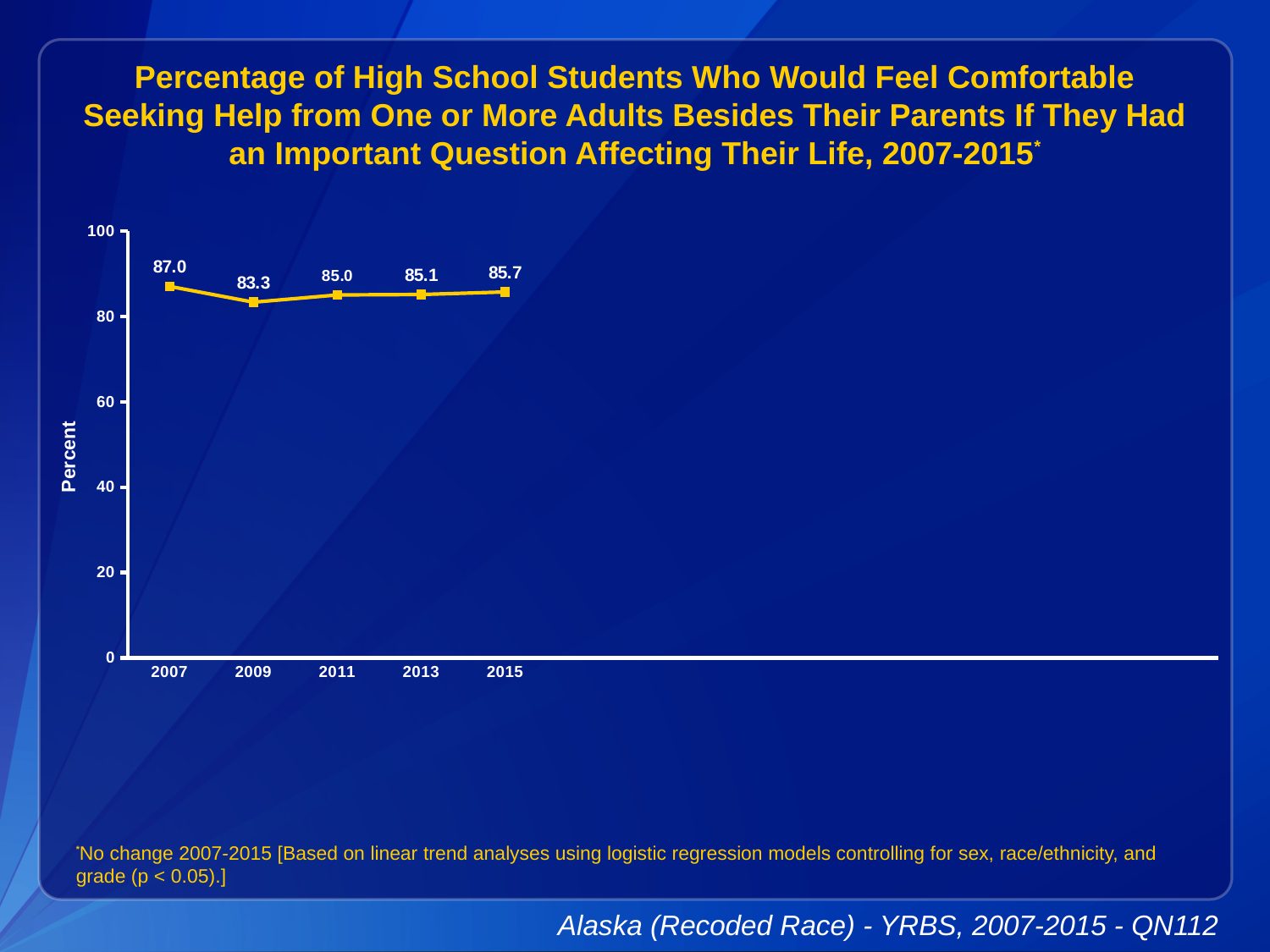
Which is larger, the value for 2007 or the value for 2015? 2007 What is the label on the y axis? Percent Which year had the highest percentage? 2007 What is the difference between the 2015 and 2011 values? 0.7 What kind of chart is shown on the slide? line chart What was the percentage of students in 2015? 85.7 How many years are plotted on the chart? 5 Which year had the lowest percentage? 2009 What is the difference between the 2007 and 2009 values? 3.7 What was the percentage of students in 2007? 87.0 Is the value for 2013 greater or less than 80? greater What was the percentage of students in 2009? 83.3